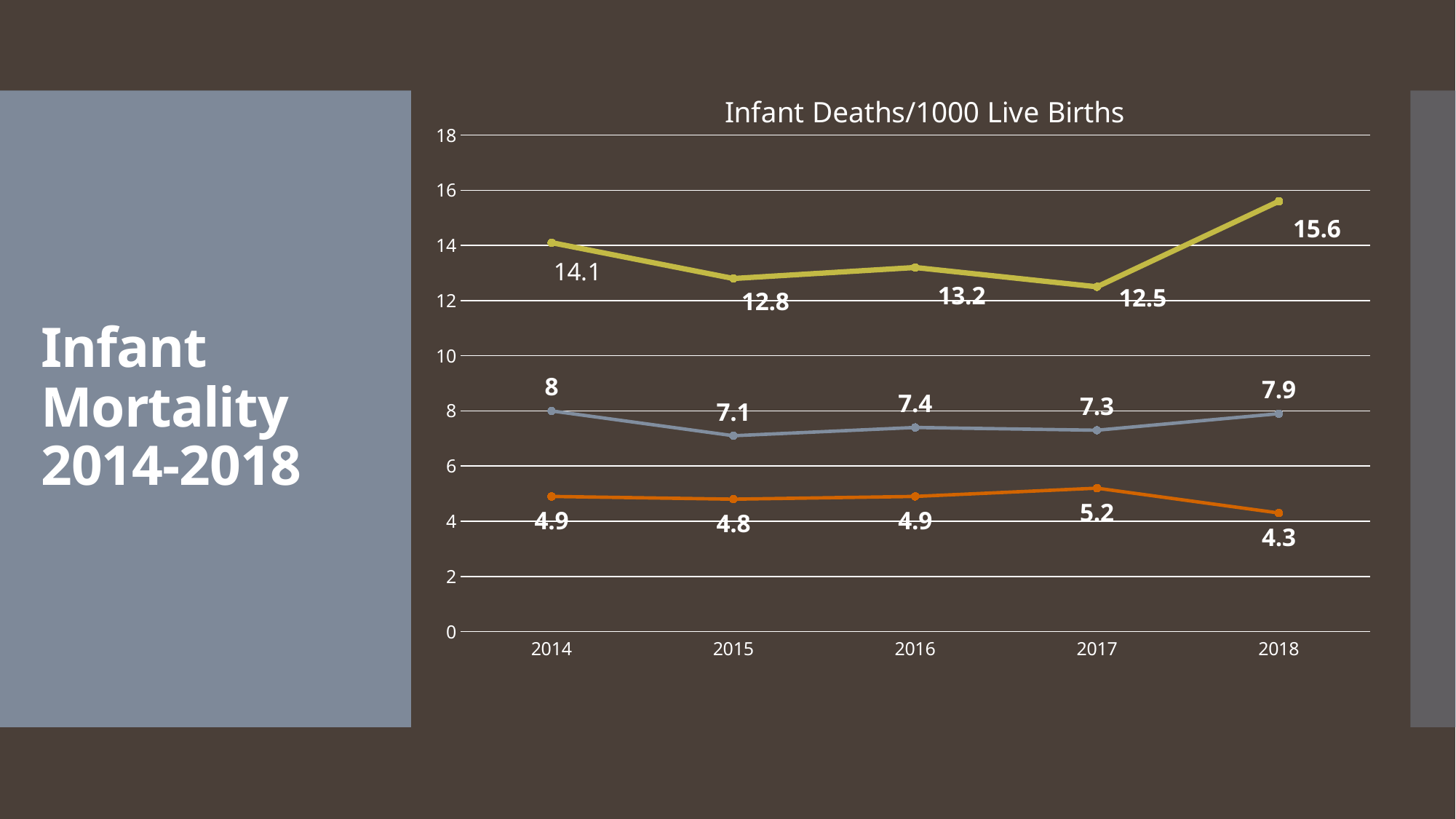
What is the value of the yellow line in 2018? 15.6 What is the value of the grey line in 2015? 7.1 Does the orange line rise or fall from 2017 to 2018? fall Is the yellow line's value in 2016 greater or less than 12? greater How many years are plotted along the x axis? 5 In which year does the orange line have its lowest value? 2018 In which year does the yellow line reach its highest value? 2018 What type of chart is shown on the slide? line chart What is the value of the orange line in 2017? 5.2 Which is larger, the grey line's value in 2014 or its value in 2018? 2014 What is the title of the chart? Infant Deaths/1000 Live Births What is the difference between the yellow line's value in 2018 and its value in 2017? 3.1